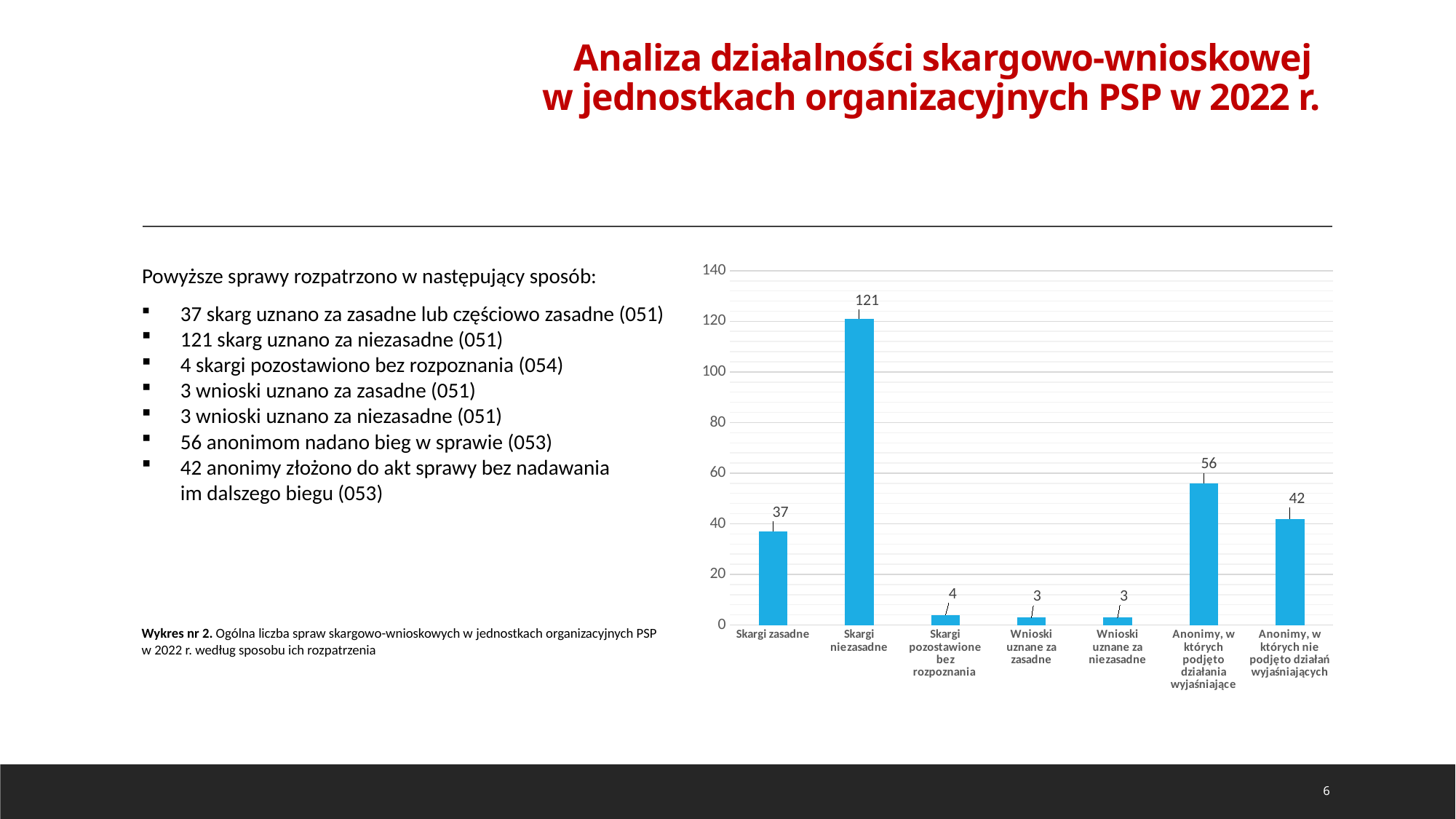
Which category has the highest value? Skargi niezasadne What is the difference between the values for "Anonimy, w których podjęto działania wyjaśniające" and "Anonimy, w których nie podjęto działań wyjaśniających"? 14 What is the value for "Skargi niezasadne"? 121 What is the value for "Skargi pozostawione bez rozpoznania"? 4 What is the maximum value shown on the vertical axis? 140 What is the value for "Wnioski uznane za zasadne"? 3 What is the difference between the values for "Skargi niezasadne" and "Skargi zasadne"? 84 Which is larger, the value for "Skargi zasadne" or the value for "Anonimy, w których nie podjęto działań wyjaśniających"? Anonimy, w których nie podjęto działań wyjaśniających How many categories are shown on the x axis? 7 What is the value for "Anonimy, w których podjęto działania wyjaśniające"? 56 Is the value for "Skargi niezasadne" greater or less than 100? greater What kind of chart is shown on the slide? bar chart